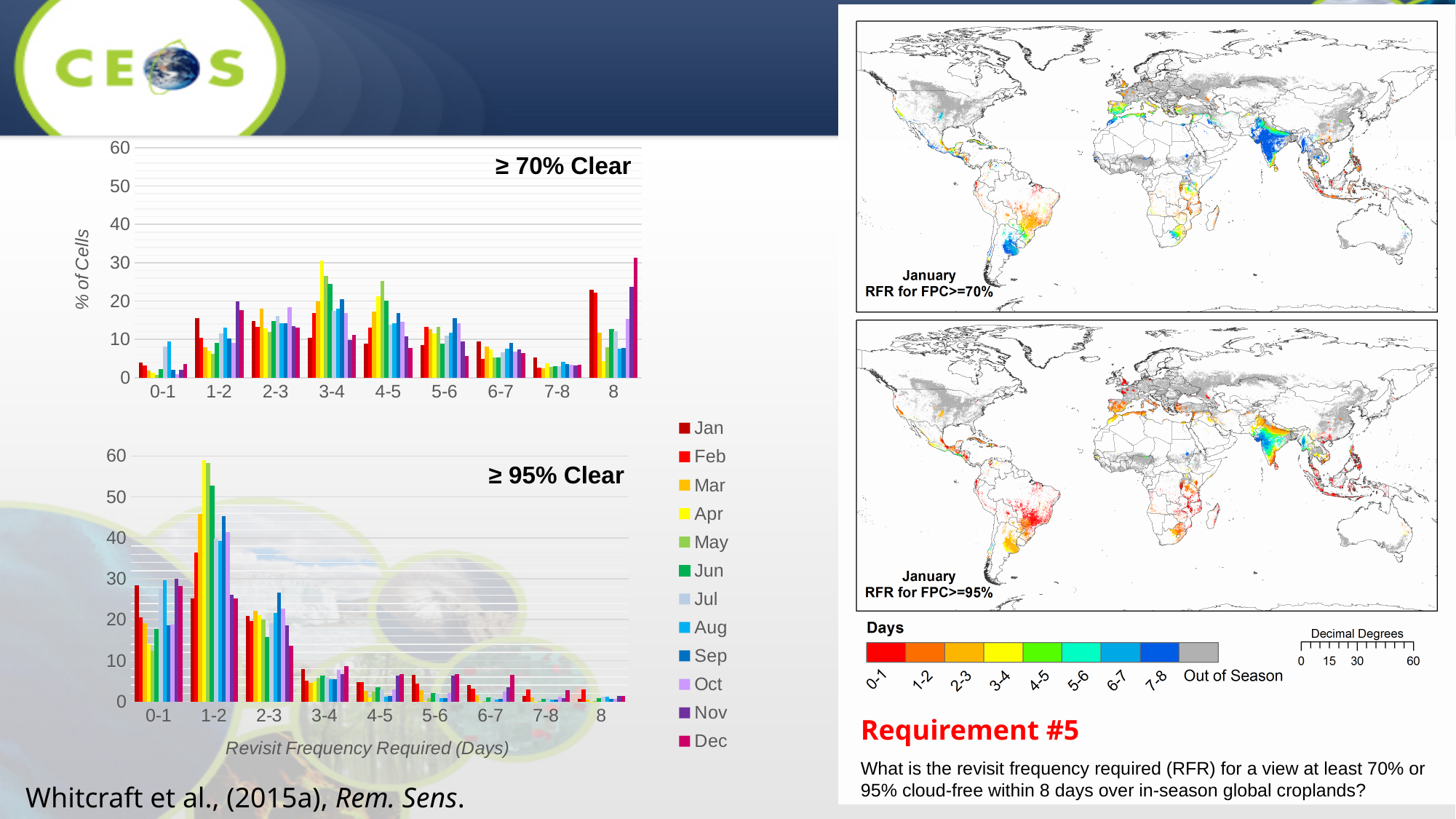
In the "≥ 95% Clear" chart, which is larger: the Feb value for 0-1 or the Feb value for 1-2? Feb value for 1-2 In the "≥ 70% Clear" chart, is the Jan value for the 0-1 category greater or less than 10? less What is the x-axis title shown below the "≥ 95% Clear" chart? Revisit Frequency Required (Days) In the "≥ 95% Clear" chart, is the Apr value for the 1-2 category greater or less than 50? greater In the "≥ 95% Clear" chart, is the Jan value for the 0-1 category greater or less than 20? greater What is the y-axis title of the "≥ 70% Clear" chart? % of Cells In the "≥ 95% Clear" chart, which revisit-frequency category contains the tallest bar? 1-2 How many series does the legend list for the charts? 12 How many revisit-frequency categories are shown on the x axis of the "≥ 95% Clear" chart? 9 What kind of chart is the "≥ 70% Clear" chart? bar chart